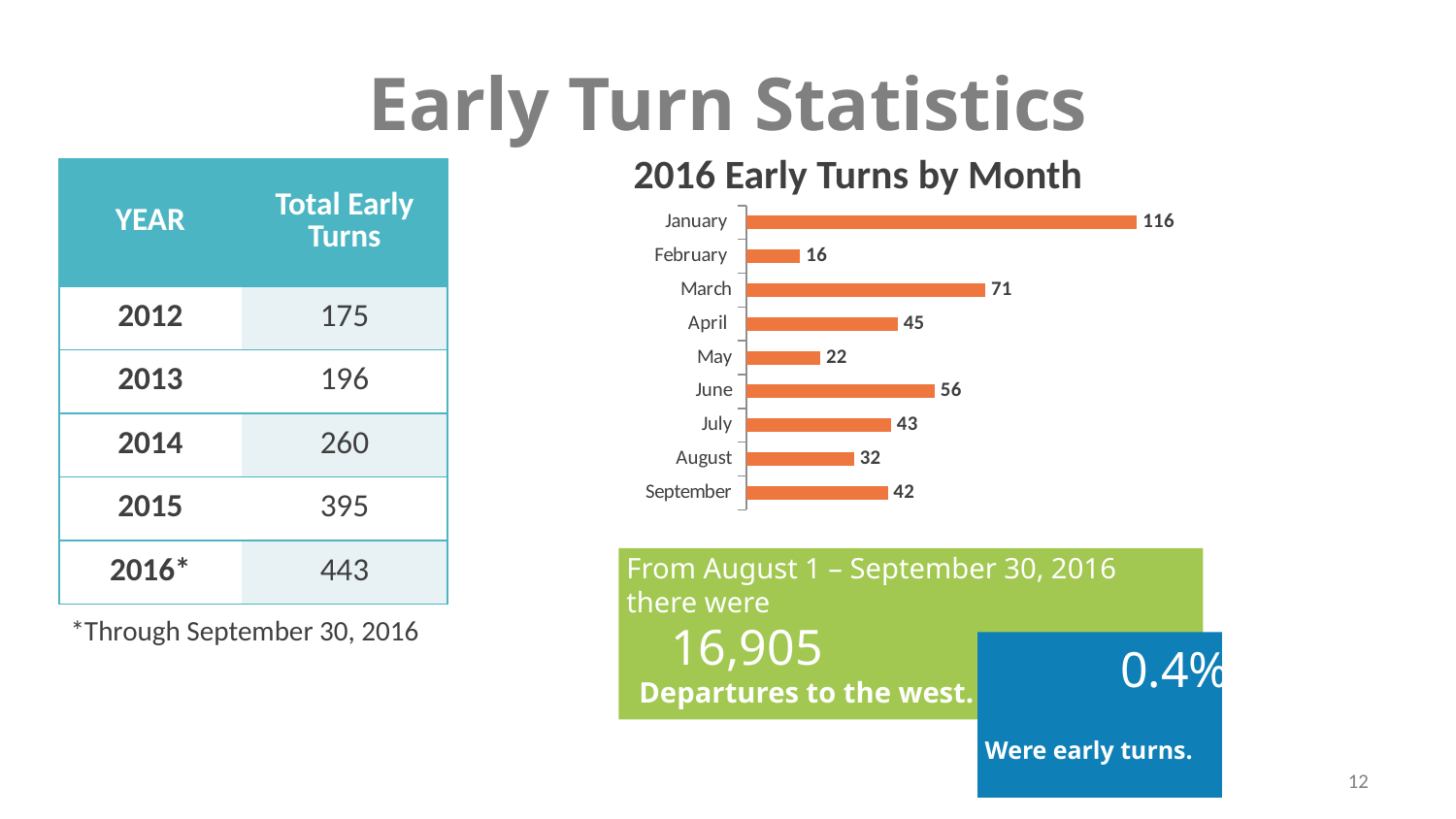
What is the difference between the values for January and February in the 2016 Early Turns by Month chart? 100 What is the value for June in the 2016 Early Turns by Month chart? 56 Which month has the lowest number of early turns in the 2016 Early Turns by Month chart? February How many months are shown in the 2016 Early Turns by Month chart? 9 What is the value for January in the 2016 Early Turns by Month chart? 116 Which is larger in the 2016 Early Turns by Month chart, the value for July or the value for August? July What is the difference between the values for March and April in the 2016 Early Turns by Month chart? 26 Which month has the highest number of early turns in the 2016 Early Turns by Month chart? January What kind of chart is the 2016 Early Turns by Month chart? Bar chart What is the title of the chart on the slide? 2016 Early Turns by Month What is the value for September in the 2016 Early Turns by Month chart? 42 Which is larger in the 2016 Early Turns by Month chart, the value for May or the value for June? June